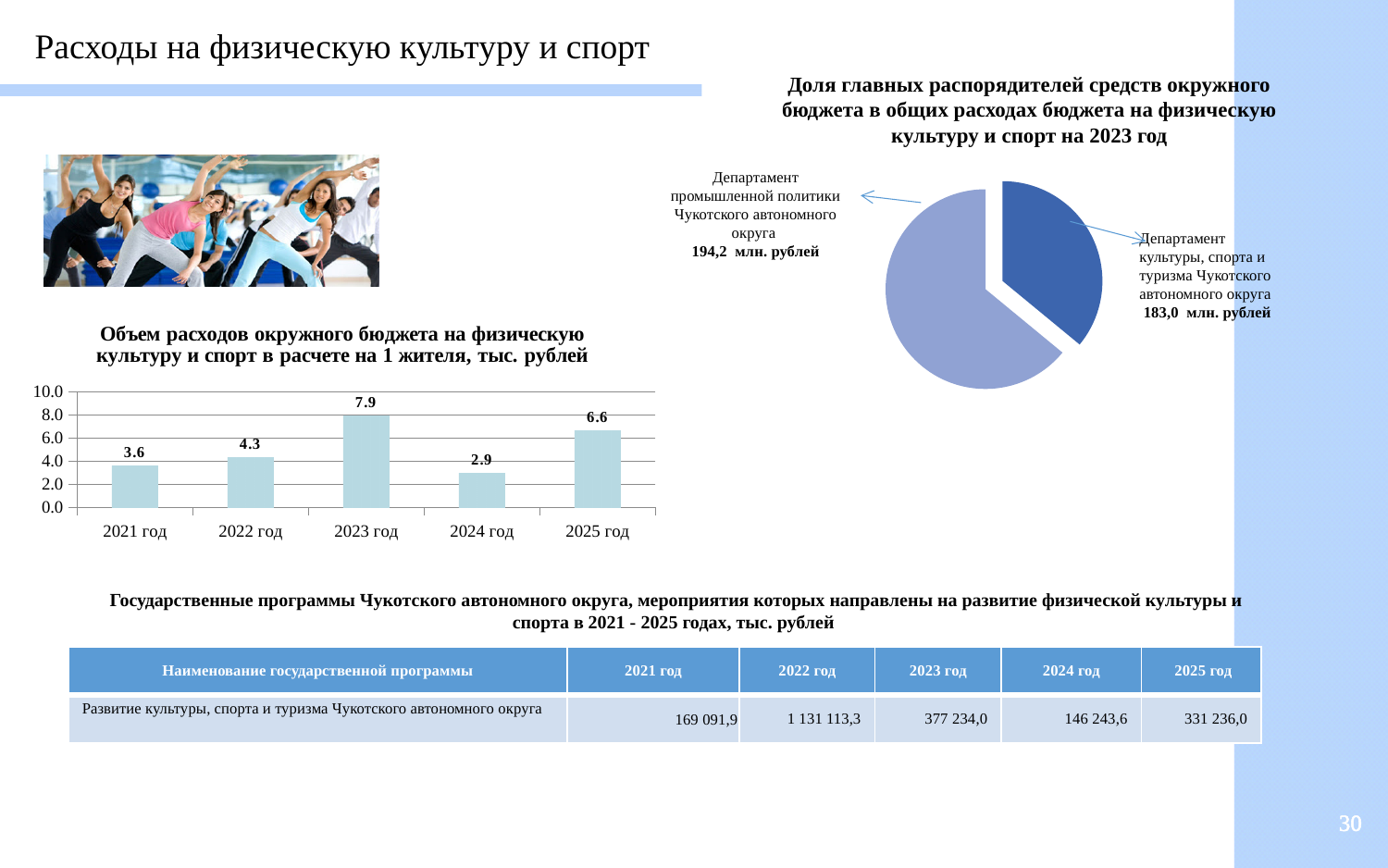
What kind of chart is 'Объем расходов окружного бюджета на физическую культуру и спорт в расчете на 1 жителя'? Bar chart On the bar chart 'Объем расходов окружного бюджета на физическую культуру и спорт в расчете на 1 жителя', which year has the highest value? 2023 год On the bar chart 'Объем расходов окружного бюджета на физическую культуру и спорт в расчете на 1 жителя', what is the value for 2023 год? 7.9 What kind of chart is 'Доля главных распорядителей средств окружного бюджета в общих расходах бюджета на физическую культуру и спорт на 2023 год'? Pie chart On the bar chart 'Объем расходов окружного бюджета на физическую культуру и спорт в расчете на 1 жителя', how many years are shown? 5 On the pie chart 'Доля главных распорядителей средств окружного бюджета...на 2023 год', what is the value for Департамент промышленной политики Чукотского автономного округа? 194,2 млн. рублей On the bar chart 'Объем расходов окружного бюджета на физическую культуру и спорт в расчете на 1 жителя', what is the value for 2021 год? 3.6 On the bar chart 'Объем расходов окружного бюджета на физическую культуру и спорт в расчете на 1 жителя', what is the difference between the values for 2023 год and 2024 год? 5.0 On the bar chart 'Объем расходов окружного бюджета на физическую культуру и спорт в расчете на 1 жителя', which year has the lowest value? 2024 год On the bar chart 'Объем расходов окружного бюджета на физическую культуру и спорт в расчете на 1 жителя', which is larger: the value for 2022 год or 2025 год? 2025 год On the pie chart 'Доля главных распорядителей средств окружного бюджета...на 2023 год', what is the value for Департамент культуры, спорта и туризма Чукотского автономного округа? 183,0 млн. рублей On the bar chart 'Объем расходов окружного бюджета на физическую культуру и спорт в расчете на 1 жителя', does the value rise or fall from 2023 год to 2024 год? Fall